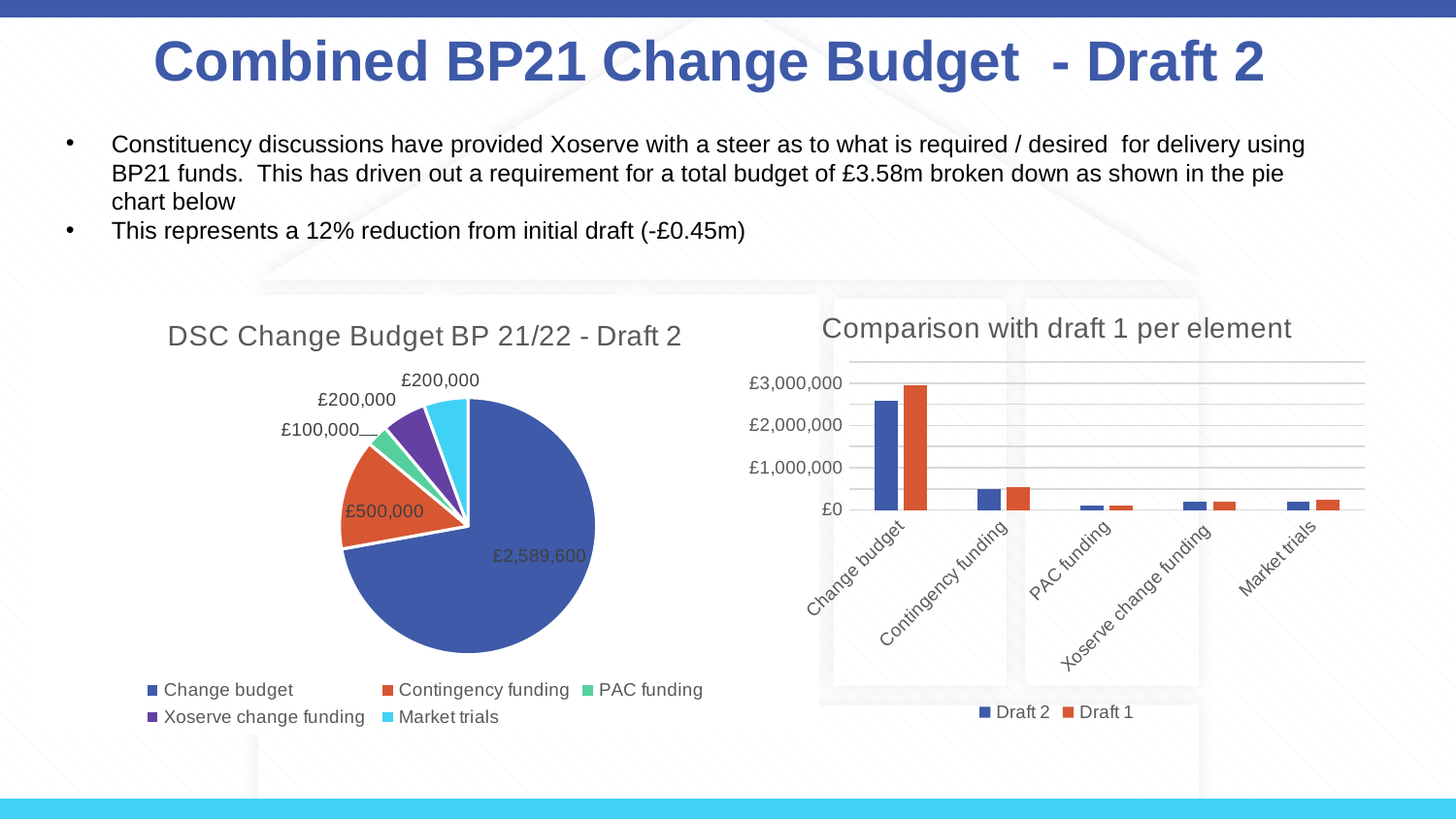
In the chart 'Comparison with draft 1 per element', is the Draft 1 value for Change budget greater or less than £2,000,000? greater In the pie chart 'DSC Change Budget BP 21/22 - Draft 2', which category has the smallest slice? PAC funding In the pie chart 'DSC Change Budget BP 21/22 - Draft 2', which category has the largest slice? Change budget In the pie chart 'DSC Change Budget BP 21/22 - Draft 2', what is the value for Contingency funding? £500,000 In the chart 'Comparison with draft 1 per element', for Change budget, which is larger: Draft 1 or Draft 2? Draft 1 How many categories are shown on the x axis of the chart 'Comparison with draft 1 per element'? 5 How many slices does the pie chart 'DSC Change Budget BP 21/22 - Draft 2' have? 5 How many series does the legend of the chart 'Comparison with draft 1 per element' list? 2 In the pie chart 'DSC Change Budget BP 21/22 - Draft 2', what is the value for PAC funding? £100,000 What kind of chart is 'Comparison with draft 1 per element'? Bar chart In the pie chart 'DSC Change Budget BP 21/22 - Draft 2', what is the value for Change budget? £2,589,600 In the pie chart 'DSC Change Budget BP 21/22 - Draft 2', what is the difference between Contingency funding and PAC funding? £400,000